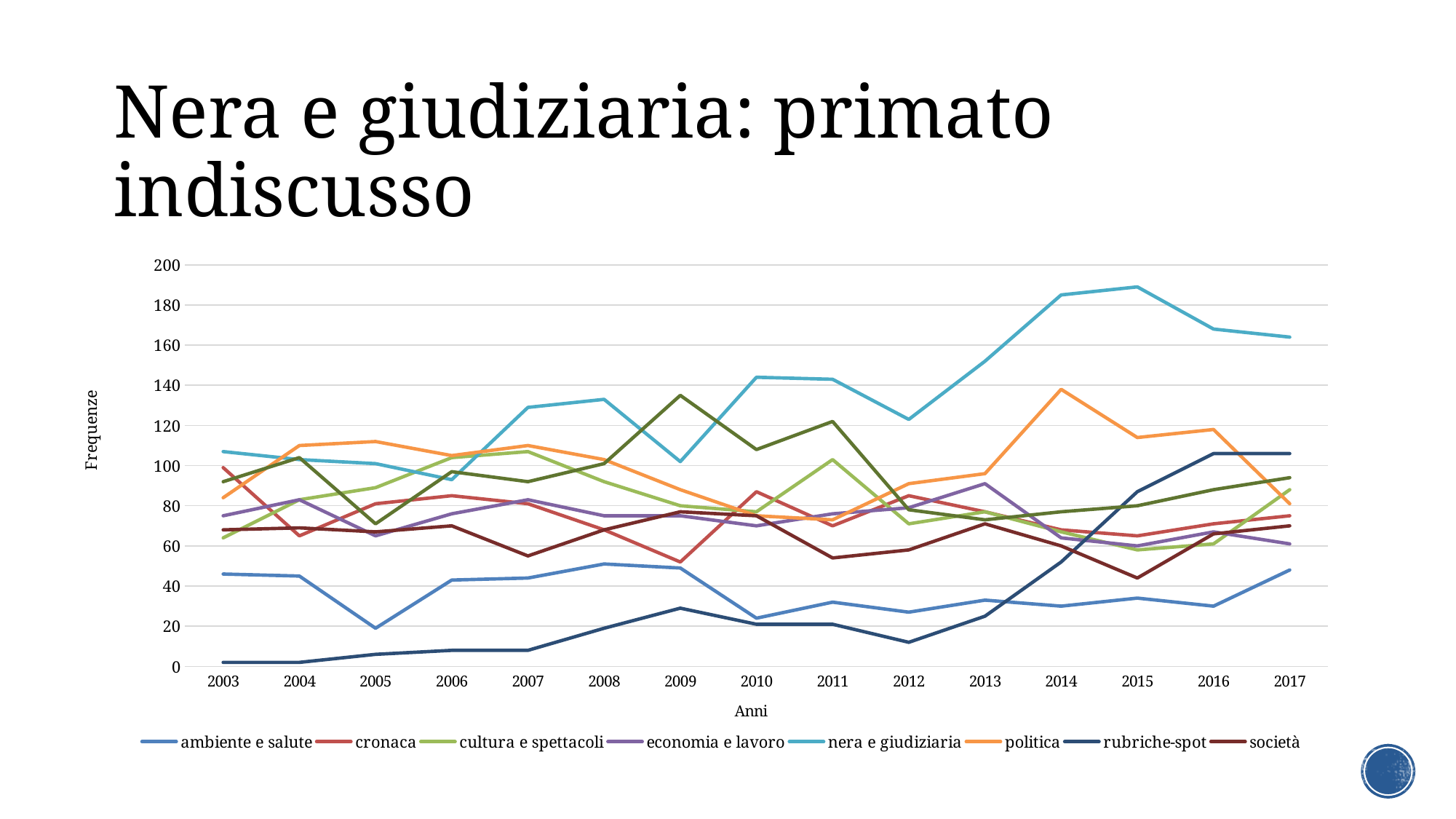
What kind of chart is shown on the slide? line chart Is the value for nera e giudiziaria in 2015 greater or less than 180? greater In 2014, which is higher: politica or nera e giudiziaria? nera e giudiziaria Is the value for ambiente e salute in 2005 greater or less than 40? less Does the rubriche-spot line rise or fall from 2012 to 2016? rise How many years are shown along the x axis? 15 Which series has the highest value in 2015? nera e giudiziaria What is the label of the y axis? Frequenze Is the value for rubriche-spot in 2003 greater or less than 20? less Which series has the lowest value in 2012? rubriche-spot How many series does the legend list? 8